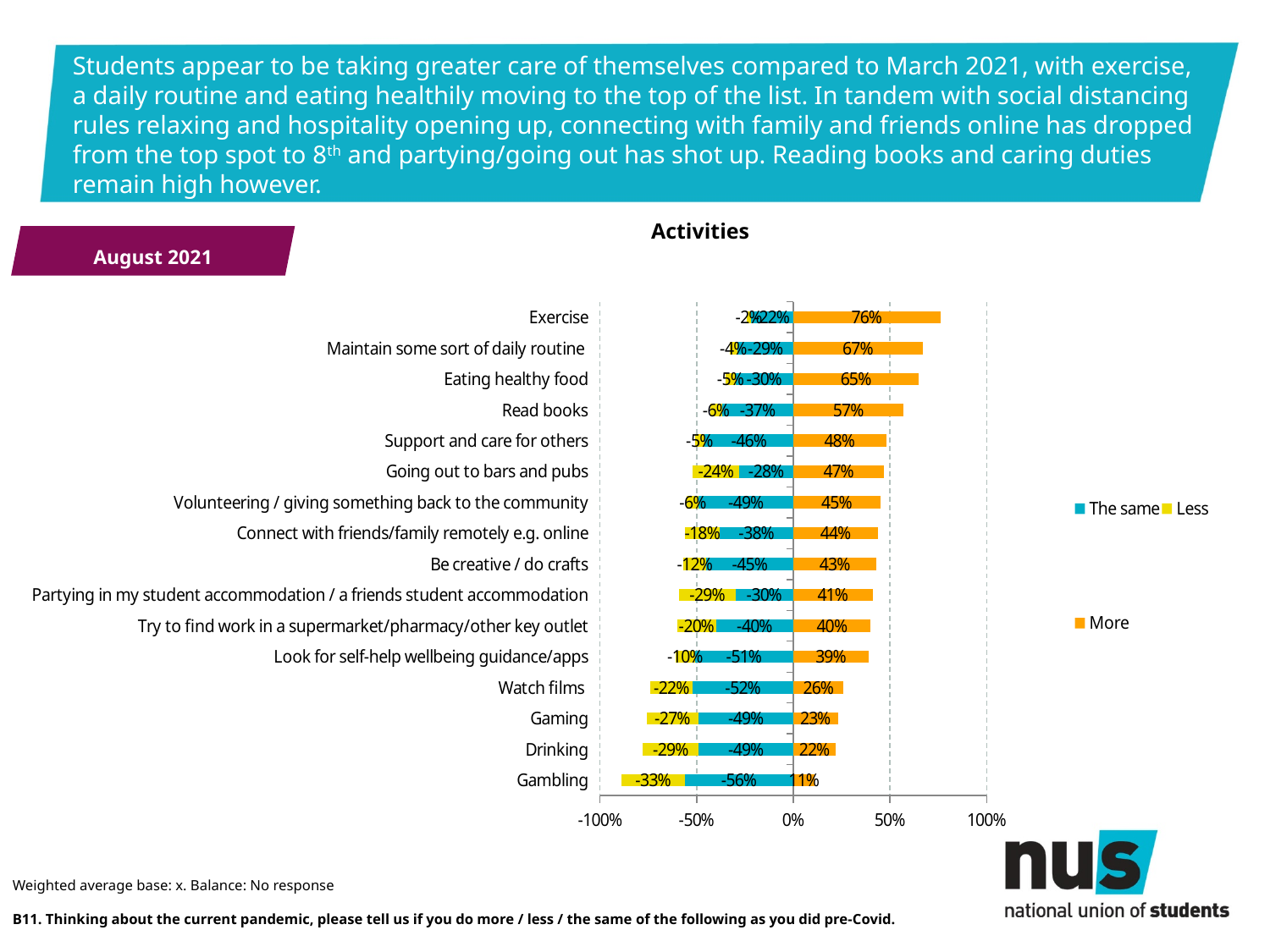
What is the 'More' value for Going out to bars and pubs? 47% What kind of chart is shown on the slide? Stacked bar chart What is the title of the chart? Activities How many activities are listed on the chart? 16 Which activity has the highest 'More' value? Exercise What is the 'The same' value for Read books? -37% What is the difference between the 'More' values for Exercise and Maintain some sort of daily routine? 9% What is the 'More' value for Exercise? 76% How many series does the legend list? 3 What is the 'Less' value for Gambling? -33% Which has a larger 'More' value, Watch films or Gaming? Watch films Which activity has the lowest 'More' value? Gambling